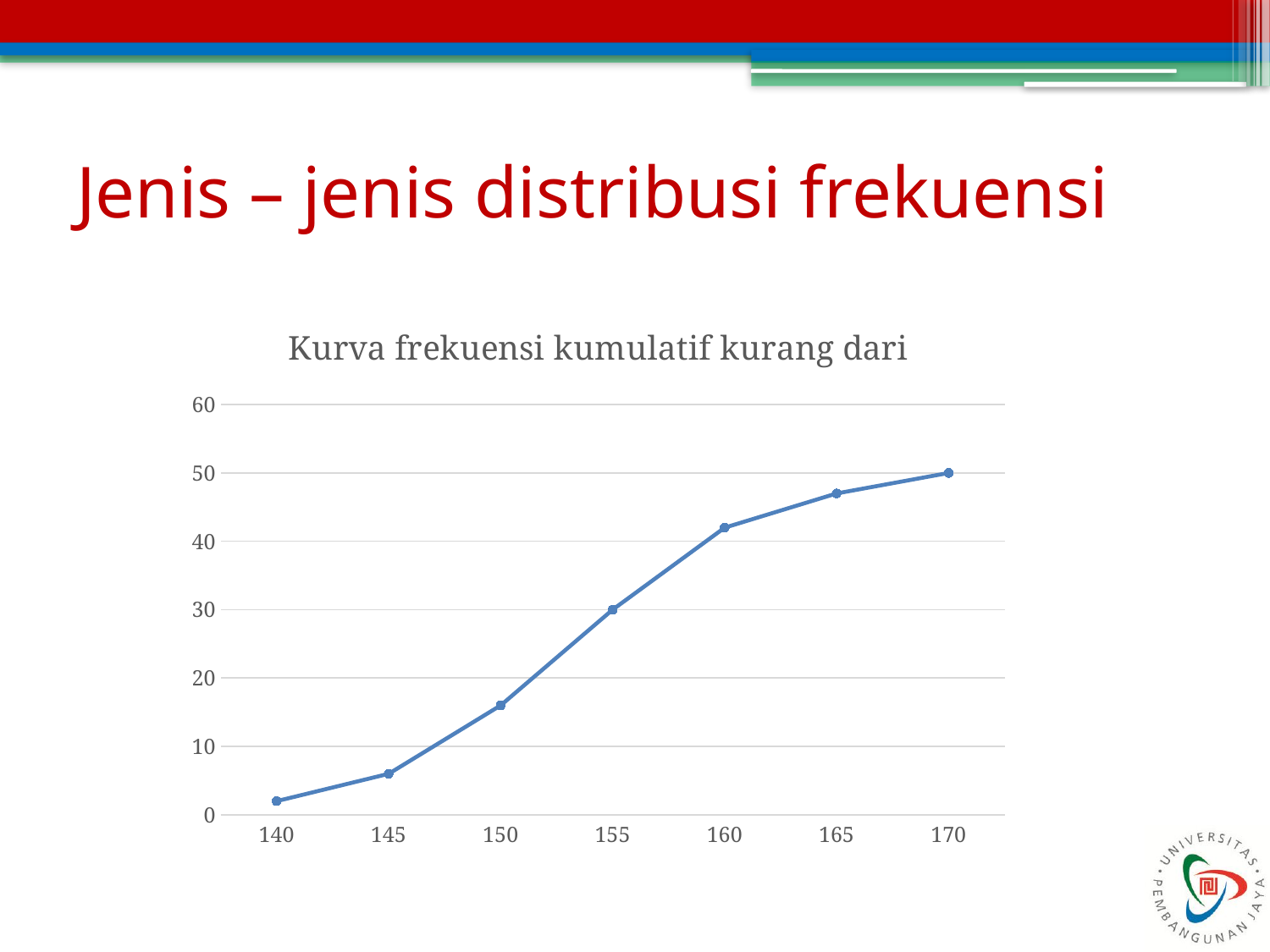
Which has the larger value, 150 or 160? 160 Is the value for 140 greater or less than 10? less What is the title of the chart? Kurva frekuensi kumulatif kurang dari How many data points are plotted on the line? 7 Is the value for 160 greater or less than 40? greater What is the value at 155? 30 What is the value at 170? 50 Which x-axis category has the lowest value? 140 What is the difference between the value at 170 and the value at 155? 20 Do the values rise or fall as the x axis goes from 140 to 170? rise What kind of chart is shown on the slide? line chart Which x-axis category has the highest value? 170